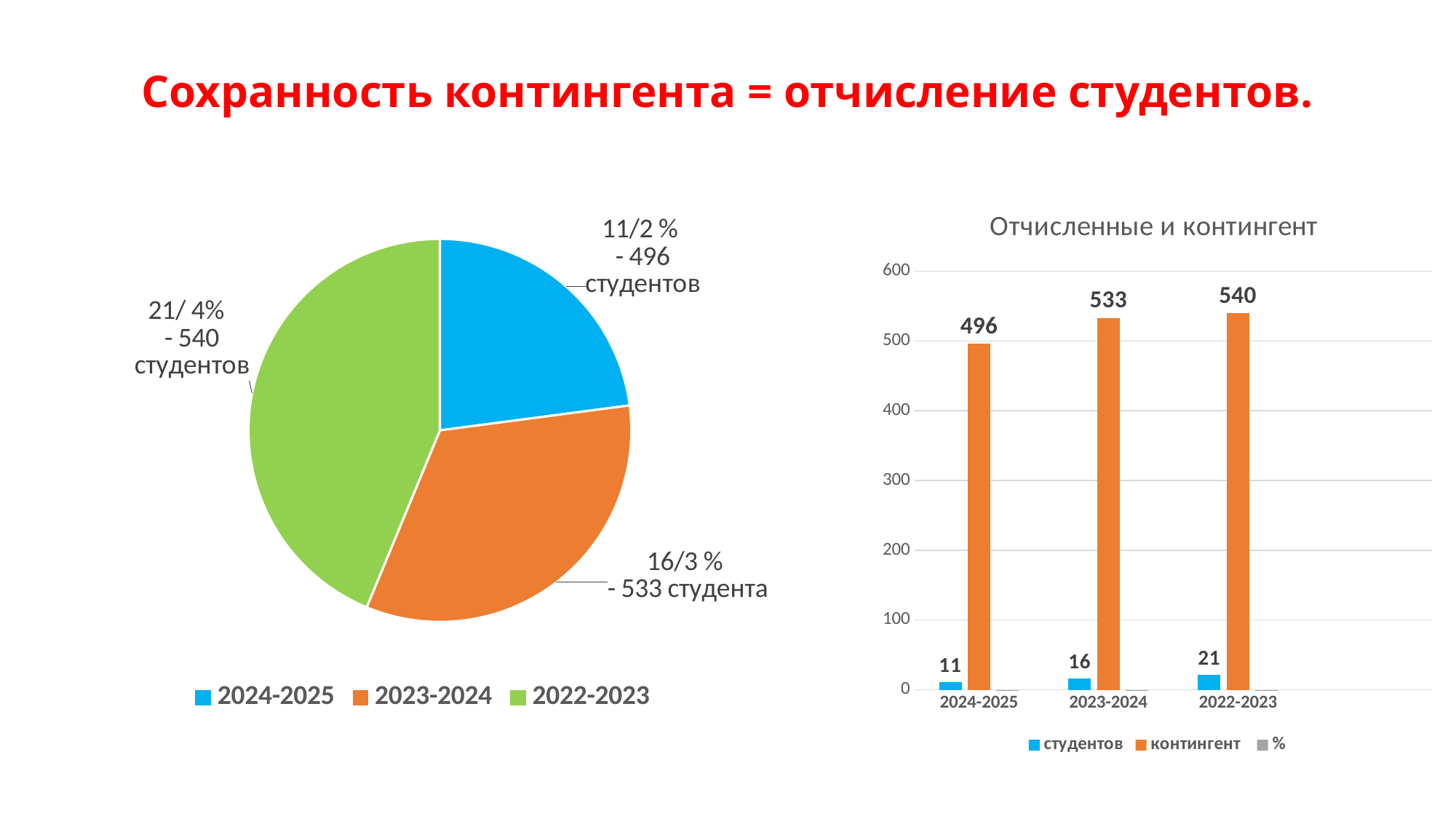
In the bar chart titled 'Отчисленные и контингент', what is the value of 'контингент' for 2024-2025? 496 In the bar chart titled 'Отчисленные и контингент', what is the difference between the 'контингент' values for 2022-2023 and 2024-2025? 44 In the bar chart titled 'Отчисленные и контингент', which year has the highest 'контингент' value? 2022-2023 In the bar chart titled 'Отчисленные и контингент', what is the difference between the 'студентов' values for 2022-2023 and 2023-2024? 5 What kind of chart is the chart on the left side of the slide? pie chart In the bar chart titled 'Отчисленные и контингент', how many year categories are shown on the x axis? 3 In the bar chart titled 'Отчисленные и контингент', is the 'контингент' value for 2024-2025 greater or less than 400? greater In the bar chart titled 'Отчисленные и контингент', do the 'контингент' values rise or fall from 2024-2025 to 2022-2023 along the x axis? rise In the pie chart on the left, which legend category has the largest slice? 2022-2023 In the bar chart titled 'Отчисленные и контингент', what is the value of 'студентов' for 2022-2023? 21 In the bar chart titled 'Отчисленные и контингент', how many series does the legend list? 3 In the bar chart titled 'Отчисленные и контингент', which year has the lowest 'студентов' value? 2024-2025